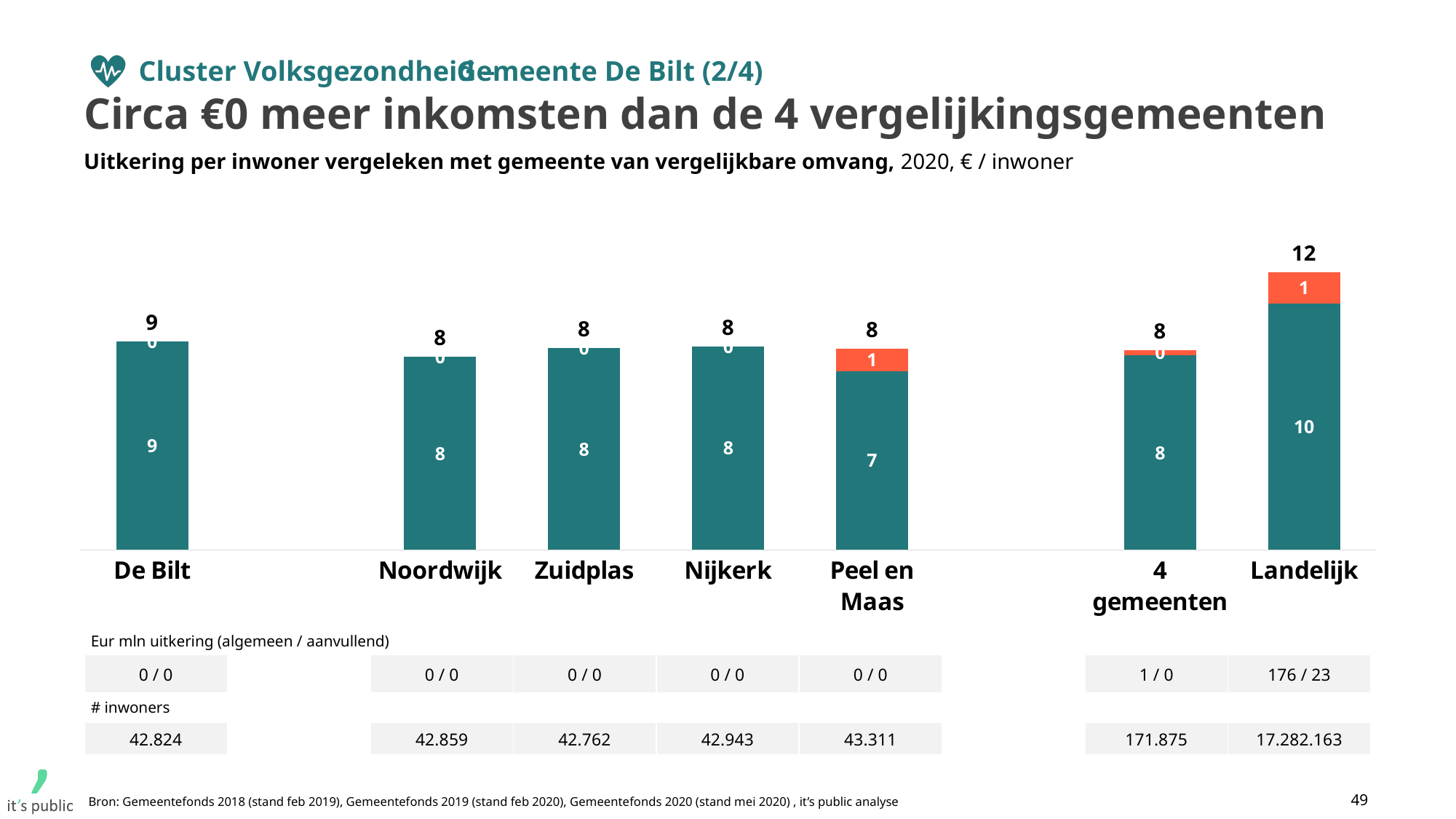
What is the total value shown above the bar for Landelijk? 12 What is the value of the orange (upper) segment of the bar for Landelijk? 1 What is the total value shown above the bar for De Bilt? 9 How many categories are shown on the x axis of the chart? 7 What is the number of inwoners listed below the chart for Landelijk? 17.282.163 Which category has the highest total value? Landelijk What is the total of the stacked bar for Peel en Maas? 8 What is the value of the teal (lower) segment of the bar for Peel en Maas? 7 What is the value of the teal (lower) segment of the bar for 4 gemeenten? 8 What kind of chart is shown on the slide? Stacked bar chart What is the difference between the total for Landelijk and the total for De Bilt? 3 Which is larger, the total for De Bilt or the total for Noordwijk? De Bilt